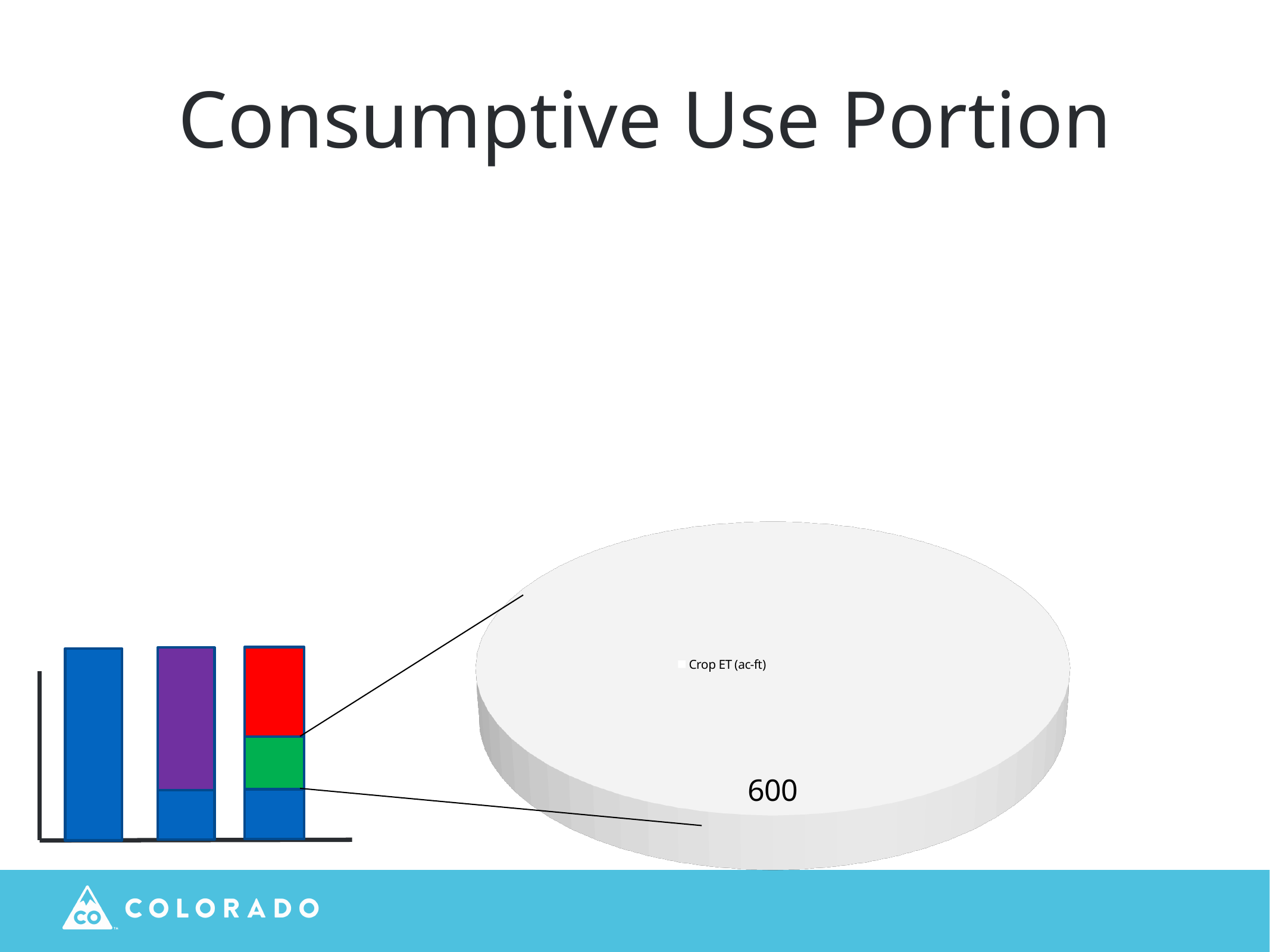
In the bar chart in the bottom-left corner, how many coloured segments does the rightmost bar have? 3 In the pie chart on the right, what value is printed on the slice? 600 How many bars does the bar chart in the bottom-left corner have? 3 In the pie chart on the right, what share of the pie does Crop ET (ac-ft) represent? 100% What kind of chart is shown in the bottom-left corner of the slide? bar chart In the pie chart on the right, what is the value for Crop ET (ac-ft)? 600 In the bar chart in the bottom-left corner, what colour is the top segment of the rightmost bar? red What kind of chart is shown on the right side of the slide? pie chart What is the legend entry shown in the pie chart on the right? Crop ET (ac-ft) How many slices does the pie chart on the right have? 1 How many entries does the legend of the pie chart on the right list? 1